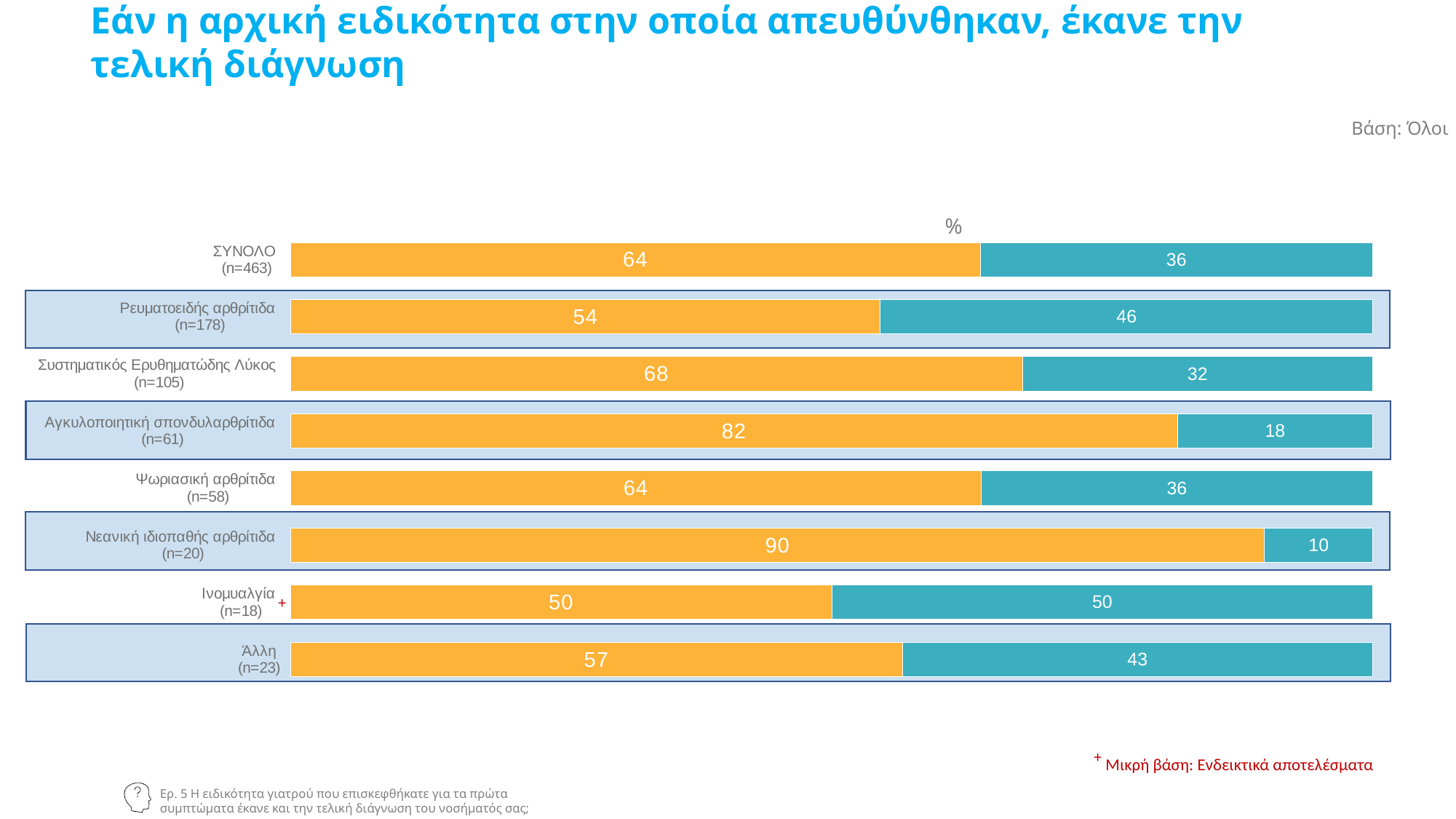
What is the value of the teal segment for Ρευματοειδής αρθρίτιδα (n=178)? 46 Which is larger: the orange segment for Άλλη (n=23) or the orange segment for Ψωριασική αρθρίτιδα (n=58)? Ψωριασική αρθρίτιδα (n=58) What is the value of the orange segment for ΣΥΝΟΛΟ (n=463)? 64 What unit symbol is shown above the bars in the chart? % What is the value of the teal segment for Αγκυλοποιητική σπονδυλαρθρίτιδα (n=61)? 18 Which category has the highest orange segment value? Νεανική ιδιοπαθής αρθρίτιδα (n=20) What is the value of the orange segment for Συστηματικός Ερυθηματώδης Λύκος (n=105)? 68 What kind of chart is shown on the slide? Stacked bar chart How many categories (rows) are plotted in the chart? 8 What is the difference between the orange segment values for Αγκυλοποιητική σπονδυλαρθρίτιδα and Ρευματοειδής αρθρίτιδα? 28 What is the total of the two segments in the bar for Ινομυαλγία (n=18)? 100 Which category has the lowest orange segment value? Ινομυαλγία (n=18)